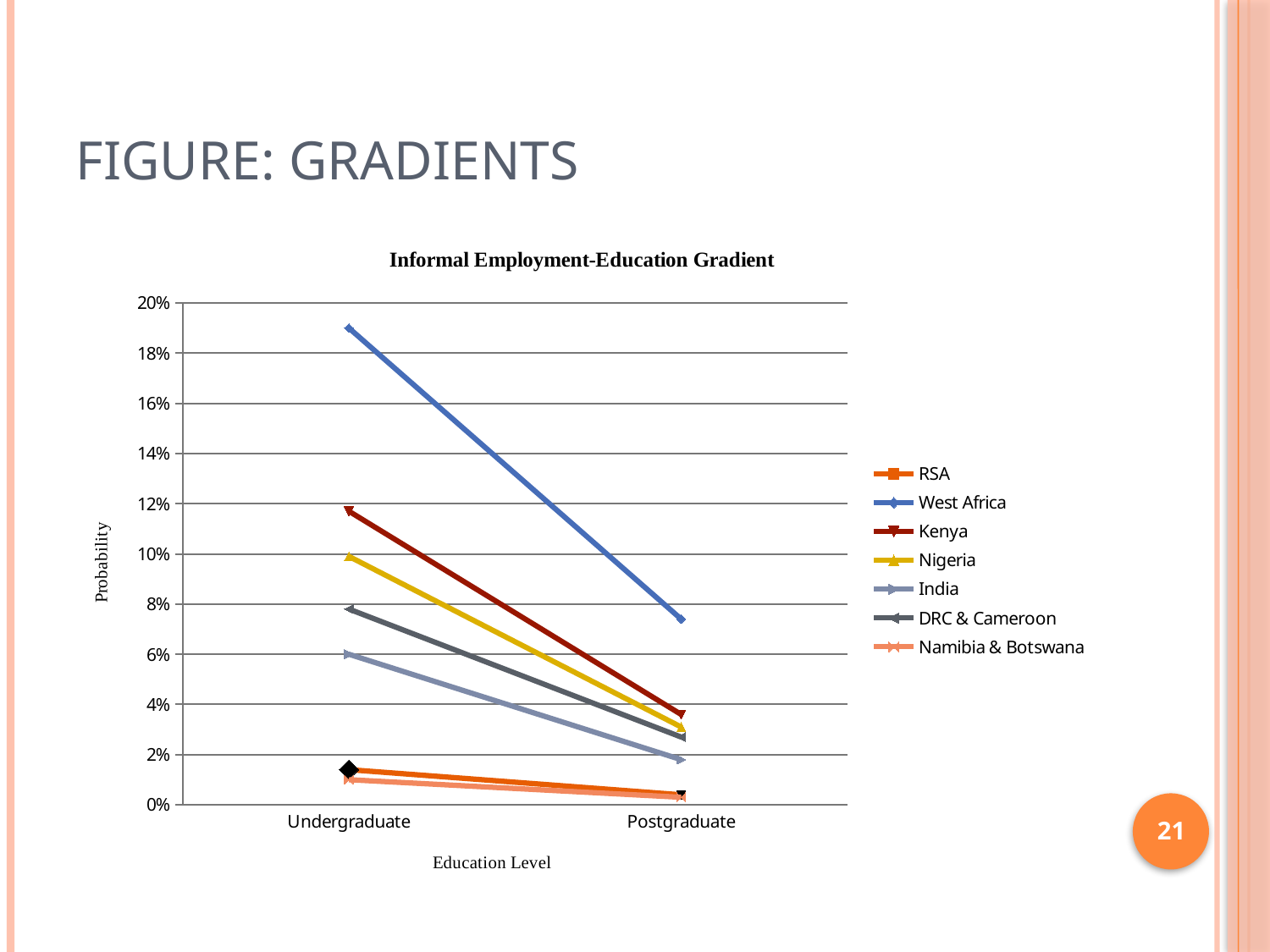
How many education levels are shown on the x axis? 2 What is the title of the chart? Informal Employment-Education Gradient Is the Undergraduate value for Kenya greater or less than 10%? greater What kind of chart is shown on the slide? Line chart Which series has the highest probability at the Undergraduate level? West Africa How many series does the legend list? 7 Which series has the highest probability at the Postgraduate level? West Africa Is the Undergraduate value for India greater or less than 8%? less At the Undergraduate level, which is larger: the value for Kenya or the value for Nigeria? Kenya Do the probabilities rise or fall from Undergraduate to Postgraduate? fall Is the Undergraduate value for West Africa greater or less than 18%? greater